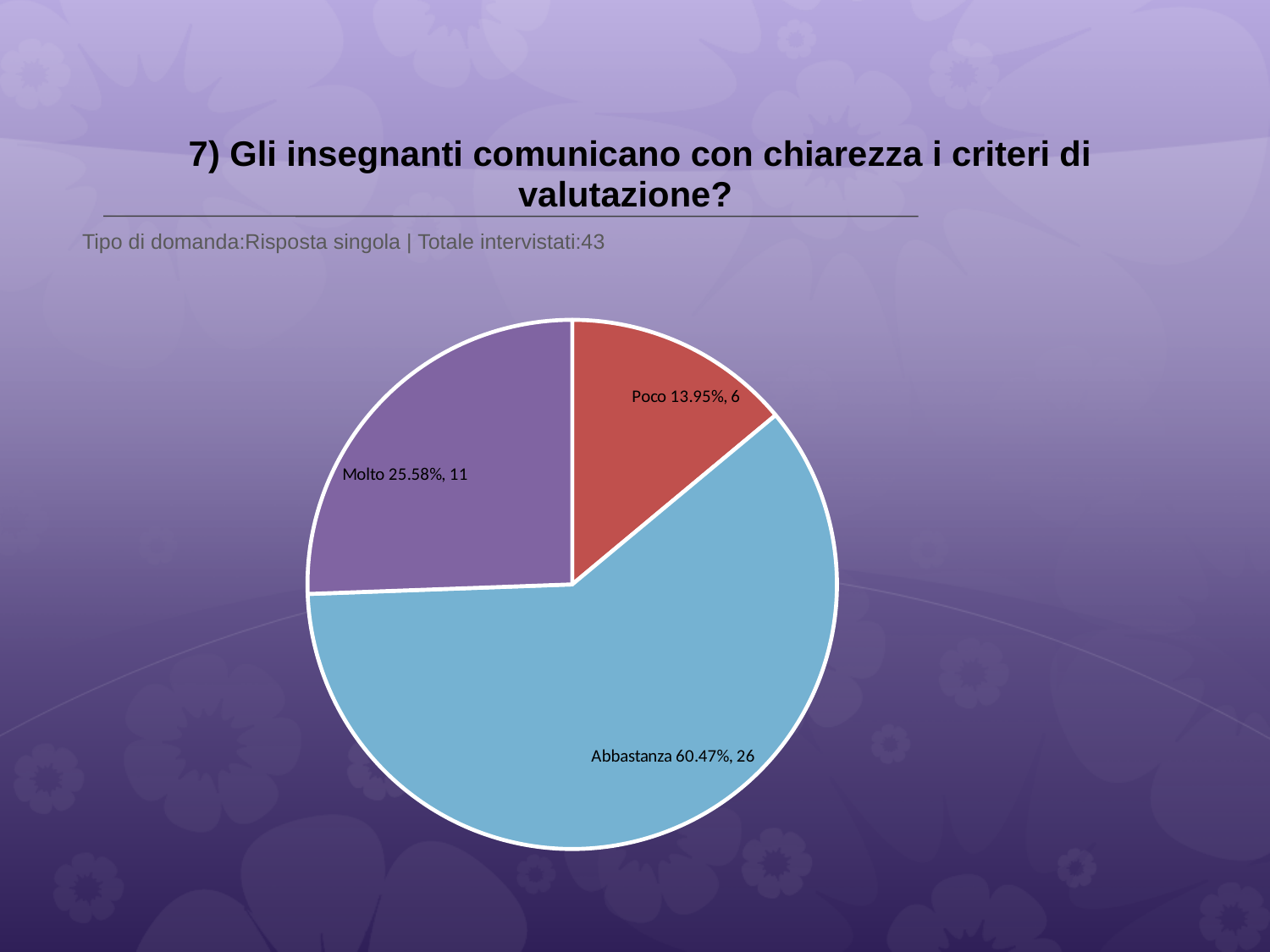
What percentage share does the Abbastanza slice have? 60.47% Which response has the smallest slice of the pie? Poco How many slices does the pie chart have? 3 Which has more respondents, Molto or Poco? Molto What colour is the Abbastanza slice? light blue What kind of chart is shown on the slide? pie chart Which response has the largest slice of the pie? Abbastanza How many respondents answered Poco? 6 What percentage share does the Poco slice have? 13.95% What is the total number of respondents across all three slices? 43 How many respondents answered Molto? 11 What is the difference in respondent count between Abbastanza and Molto? 15